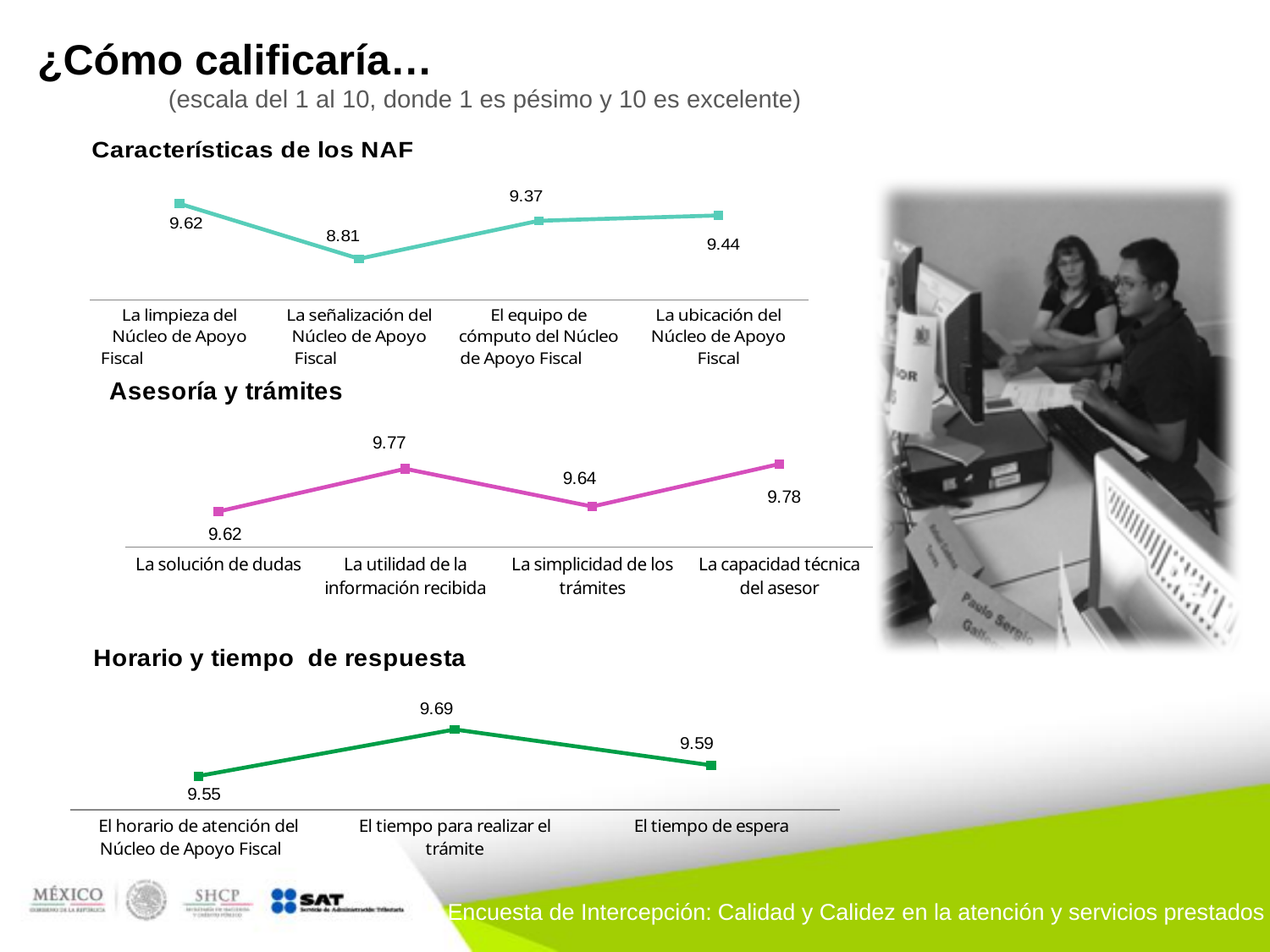
In the 'Horario y tiempo de respuesta' chart, how many categories are plotted? 3 In the 'Asesoría y trámites' chart, which is larger: the value for 'La solución de dudas' or the value for 'La utilidad de la información recibida'? La utilidad de la información recibida In the 'Horario y tiempo de respuesta' chart, what is the value for 'El tiempo de espera'? 9.59 In the 'Horario y tiempo de respuesta' chart, which category has the highest value? El tiempo para realizar el trámite In the 'Características de los NAF' chart, what is the value for 'La señalización del Núcleo de Apoyo Fiscal'? 8.81 In the 'Características de los NAF' chart, what is the difference between the values for 'La limpieza del Núcleo de Apoyo Fiscal' and 'La señalización del Núcleo de Apoyo Fiscal'? 0.81 In the 'Características de los NAF' chart, how many categories are plotted? 4 What kind of chart is the 'Horario y tiempo de respuesta' chart? Line chart In the 'Características de los NAF' chart, which category has the highest value? La limpieza del Núcleo de Apoyo Fiscal In the 'Asesoría y trámites' chart, what is the value for 'La capacidad técnica del asesor'? 9.78 In the 'Asesoría y trámites' chart, what is the value for 'La utilidad de la información recibida'? 9.77 In the 'Características de los NAF' chart, which category has the lowest value? La señalización del Núcleo de Apoyo Fiscal